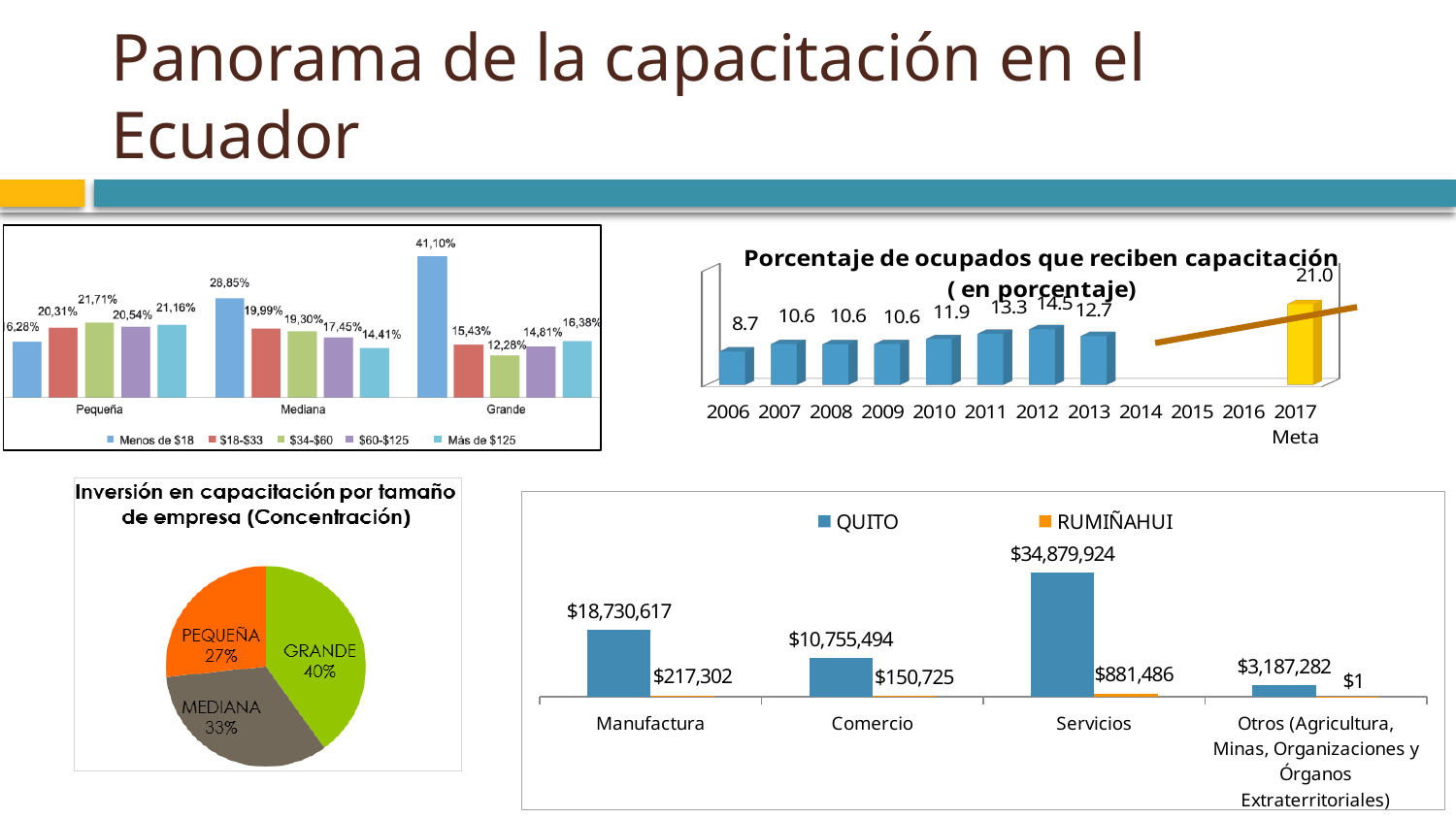
In the pie chart 'Inversión en capacitación por tamaño de empresa (Concentración)', which slice is the largest? GRANDE In the chart 'Porcentaje de ocupados que reciben capacitación', what is the value for 2006? 8.7 In the top-left bar chart, how many series does the legend list? 5 In the bottom-right chart comparing QUITO and RUMIÑAHUI, which category has the highest QUITO value? Servicios In the pie chart 'Inversión en capacitación por tamaño de empresa (Concentración)', what share does MEDIANA have? 33% In the top-left bar chart, what is the value for 'Menos de $18' in the Grande group? 41,10% In the bottom-right chart comparing QUITO and RUMIÑAHUI, which category has the lowest RUMIÑAHUI value? Otros (Agricultura, Minas, Organizaciones y Órganos Extraterritoriales) In the bottom-right chart comparing QUITO and RUMIÑAHUI, what is the value for RUMIÑAHUI in Manufactura? $217,302 In the bottom-right chart comparing QUITO and RUMIÑAHUI, what is the value for QUITO in Servicios? $34,879,924 In the bottom-right chart comparing QUITO and RUMIÑAHUI, how many series does the legend list? 2 In the chart 'Porcentaje de ocupados que reciben capacitación', what is the value for the 2017 Meta? 21.0 In the chart 'Porcentaje de ocupados que reciben capacitación', which year between 2006 and 2013 has the highest value? 2012